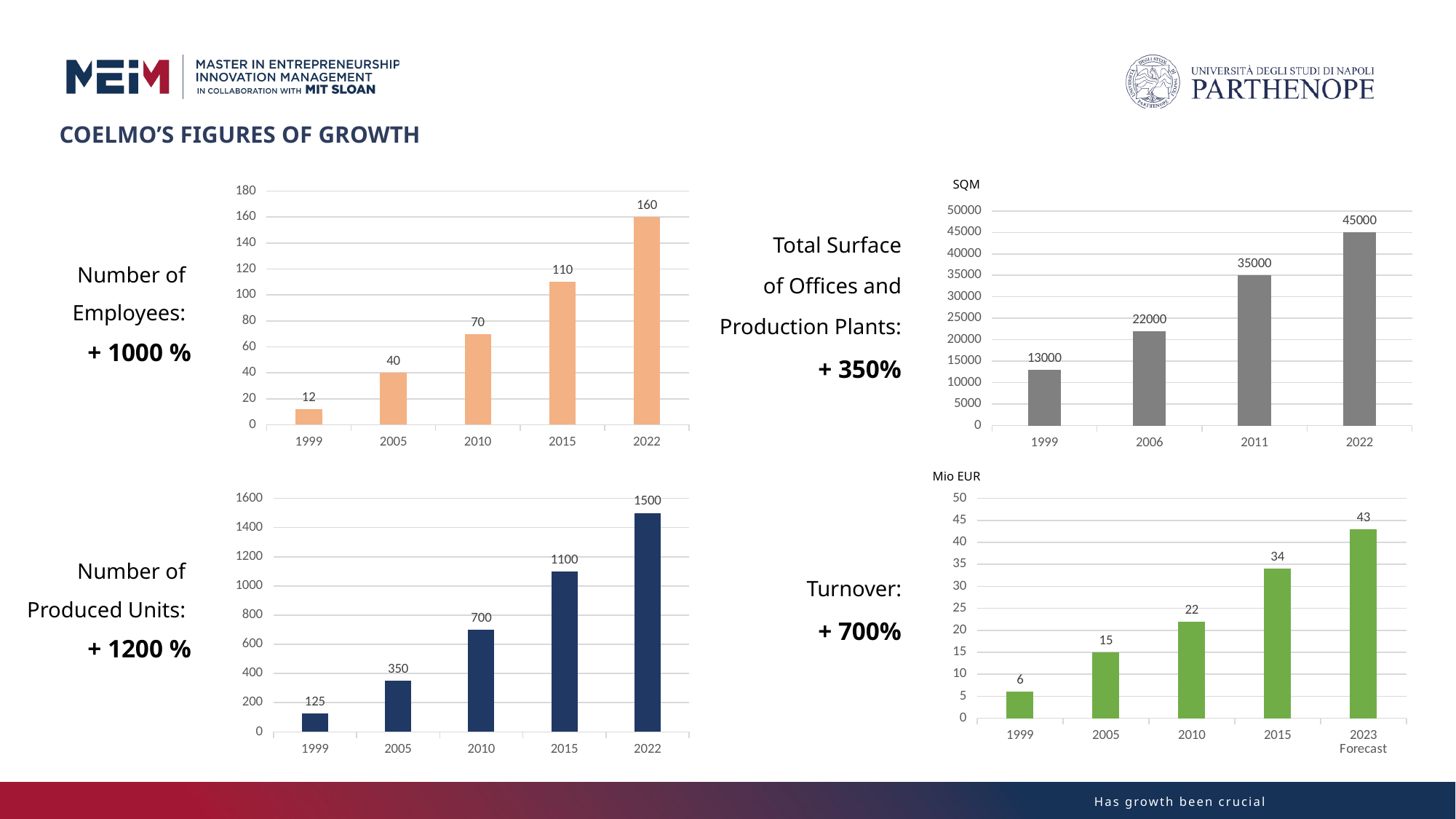
In the Total Surface of Offices and Production Plants chart, how many years are shown? 4 In the Number of Produced Units chart, what is the value for 2015? 1100 In the Total Surface of Offices and Production Plants chart, which year has the lowest value? 1999 In the Turnover chart, what is the value for 2023 Forecast? 43 In the Number of Employees chart, what is the difference between the 2022 and 1999 values? 148 In the Number of Employees chart, which year has the highest value? 2022 In the Total Surface of Offices and Production Plants chart, what is the value for 2006? 22000 In the Number of Employees chart, what is the value for 2010? 70 In the Number of Produced Units chart, do the values rise or fall from 1999 to 2022? rise What type of chart is the Turnover chart? bar chart In the Turnover chart, which is larger, the value for 2010 or the value for 2005? 2010 In the Number of Produced Units chart, what is the difference between the 2010 and 2005 values? 350